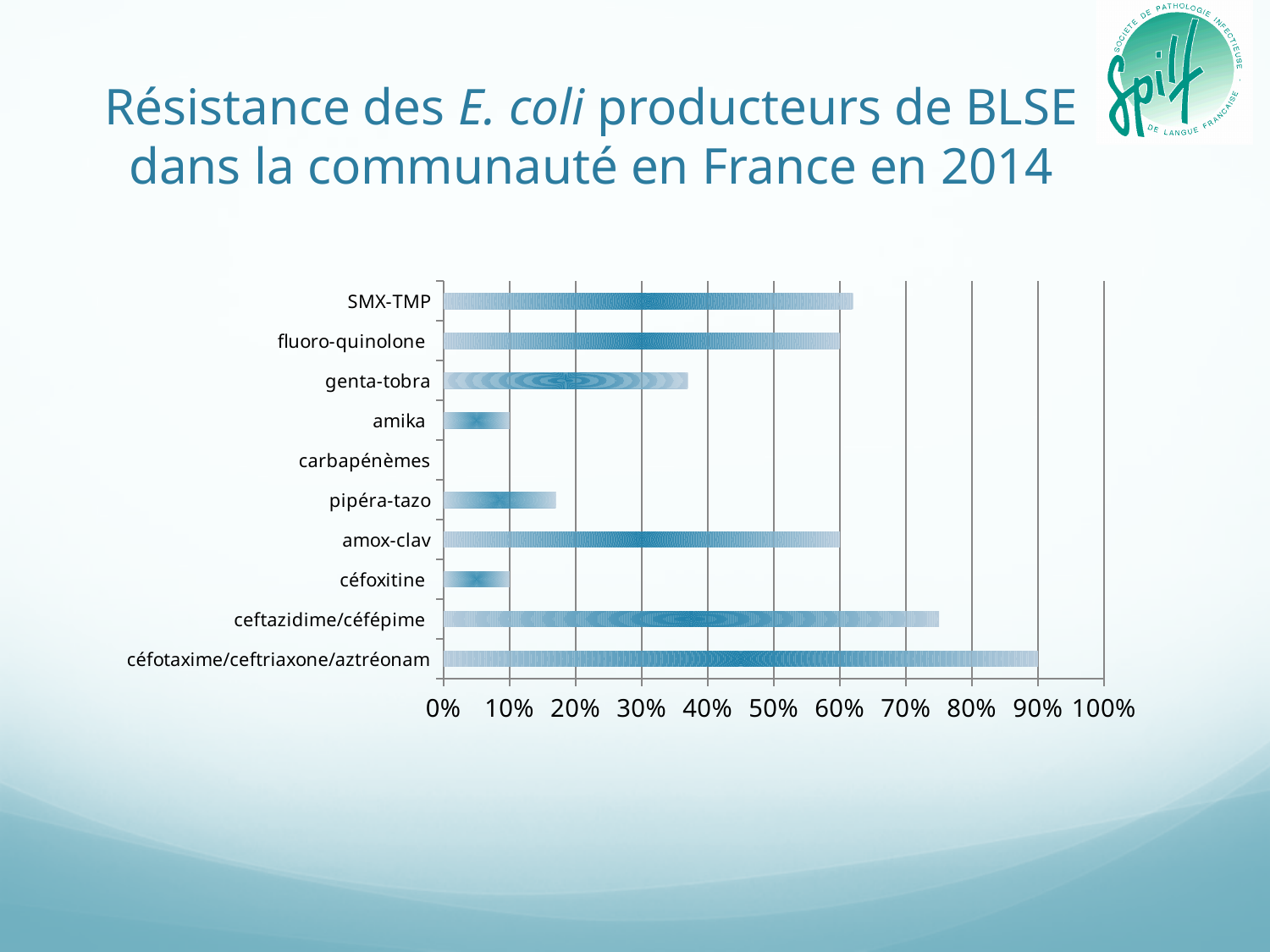
What is the resistance value for céfoxitine? 10% What is the title of the slide containing the chart? Résistance des E. coli producteurs de BLSE dans la communauté en France en 2014 Is the value for genta-tobra greater or less than 40%? less What kind of chart is shown on the slide? bar chart Which category has the highest resistance value? céfotaxime/ceftriaxone/aztréonam Which is larger, the value for SMX-TMP or the value for genta-tobra? SMX-TMP What is the resistance value for amika? 10% How many antibiotic categories are plotted on the chart? 10 Is the value for pipéra-tazo greater or less than 20%? less Which category has the lowest resistance value? carbapénèmes Is the value for ceftazidime/céfépime greater or less than 70%? greater What is the resistance value for céfotaxime/ceftriaxone/aztréonam? 90%